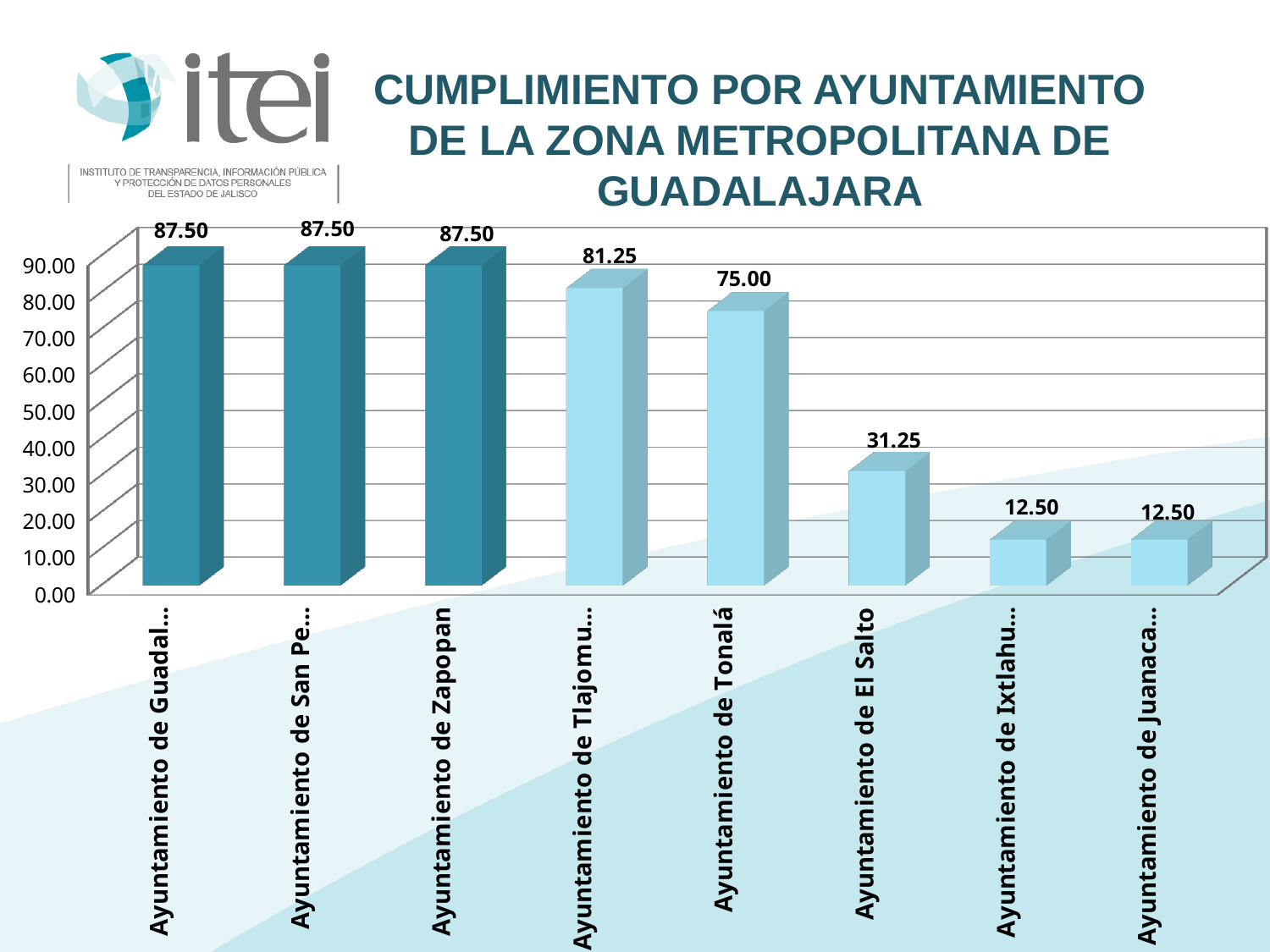
What is the lowest value shown on the chart? 12.50 What kind of chart is shown on the slide? bar chart Is the value for Ayuntamiento de El Salto greater or less than 40.00? less Which has a larger value, Ayuntamiento de Tonalá or Ayuntamiento de El Salto? Ayuntamiento de Tonalá Do the values rise or fall from left to right across the chart? fall What is the difference between the values for Ayuntamiento de Zapopan and Ayuntamiento de Tonalá? 12.50 How many ayuntamientos (bars) are shown on the chart? 8 What is the highest value shown on the chart? 87.50 What is the value for Ayuntamiento de Tonalá? 75.00 What is the difference between the values for Ayuntamiento de Tonalá and Ayuntamiento de El Salto? 43.75 What is the value for Ayuntamiento de El Salto? 31.25 What is the value for Ayuntamiento de Zapopan? 87.50